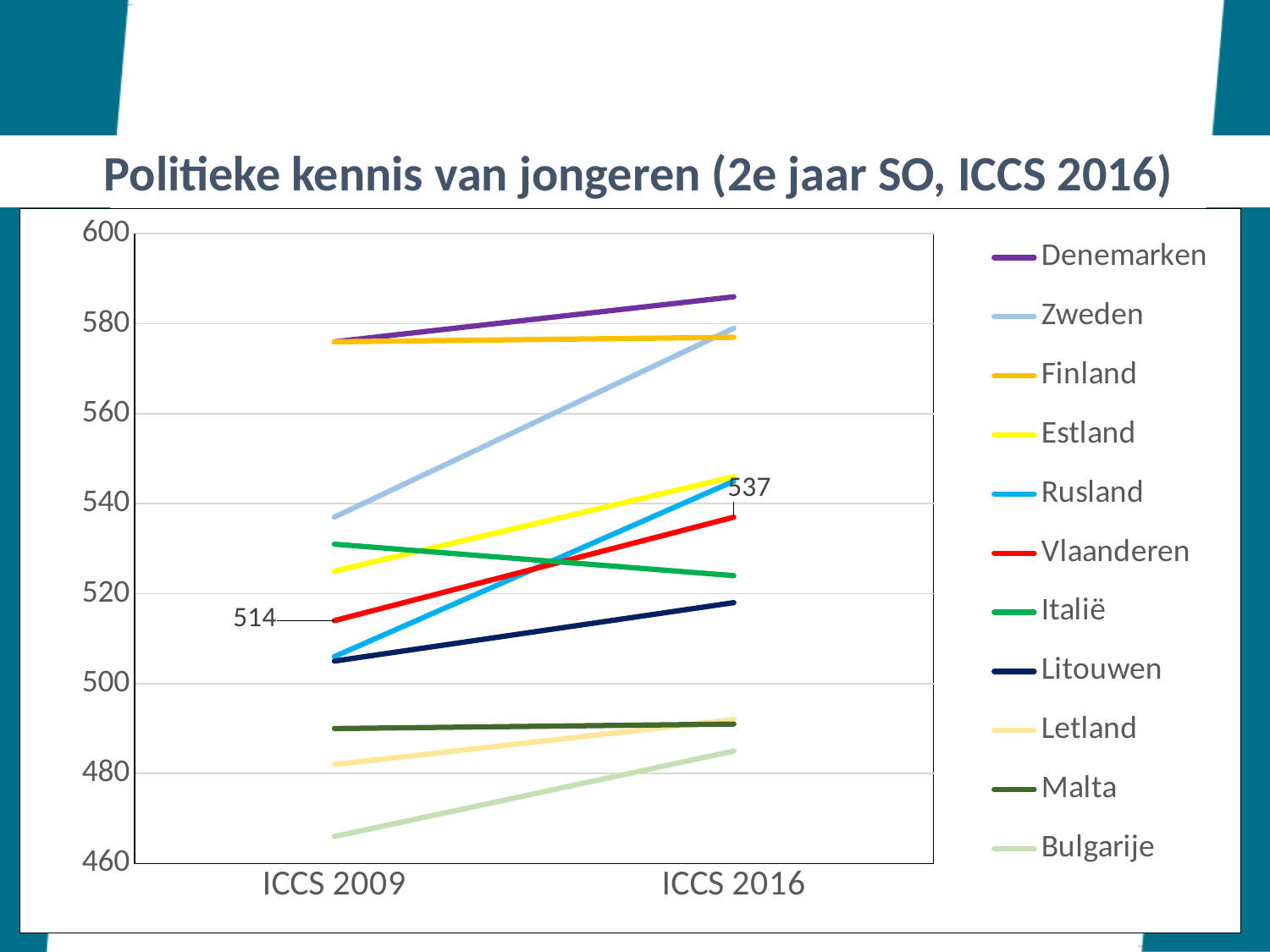
How many points are shown on the x axis? 2 Is the value for Bulgarije at ICCS 2009 greater or less than 480? less Which country has the lowest value at ICCS 2009? Bulgarije Does the value for Italië rise or fall from ICCS 2009 to ICCS 2016? Fall What kind of chart is shown on the slide? Line chart Which country has the highest value at ICCS 2016? Denemarken By how much did the value for Vlaanderen change from ICCS 2009 to ICCS 2016? 23 How many series does the legend list? 11 What is the title of the chart on the slide? Politieke kennis van jongeren (2e jaar SO, ICCS 2016) What is the value for Vlaanderen at ICCS 2009? 514 What is the value for Vlaanderen at ICCS 2016? 537 Is the value for Denemarken at ICCS 2016 greater or less than 580? greater